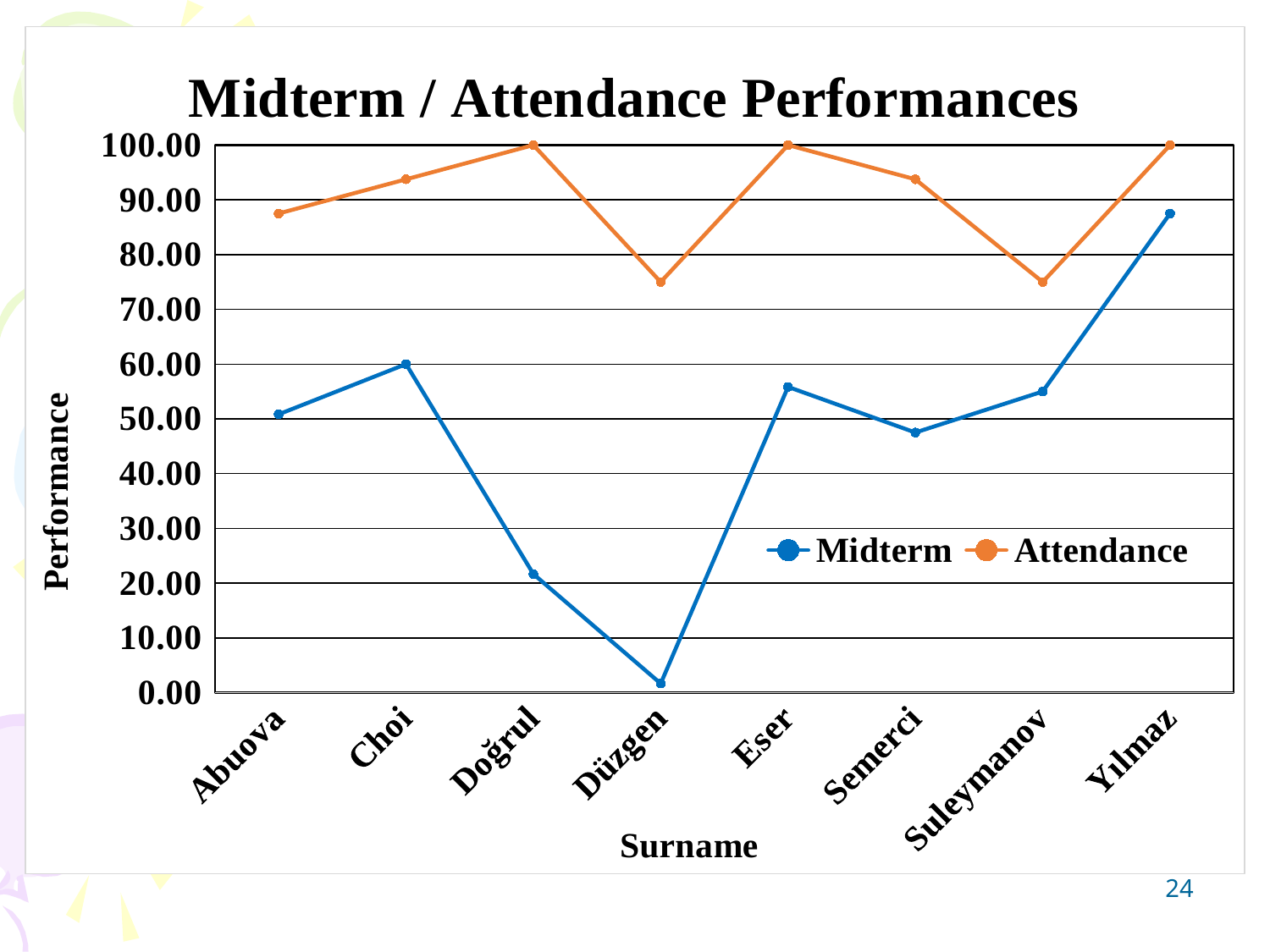
What is the label of the y axis? Performance Which is larger, the Midterm value for Eser or the Midterm value for Semerci? Eser How many surnames are plotted along the x axis? 8 Is the Midterm value for Düzgen greater or less than 10.00? less What is the Attendance value for Yılmaz? 100.00 What is the title of the chart? Midterm / Attendance Performances Which surname has the lowest Midterm value? Düzgen Is the Attendance value for Abuova greater or less than 80.00? greater What kind of chart is shown on the slide? line chart Which surname has the highest Midterm value? Yılmaz What is the Attendance value for Doğrul? 100.00 How many series does the legend list? 2